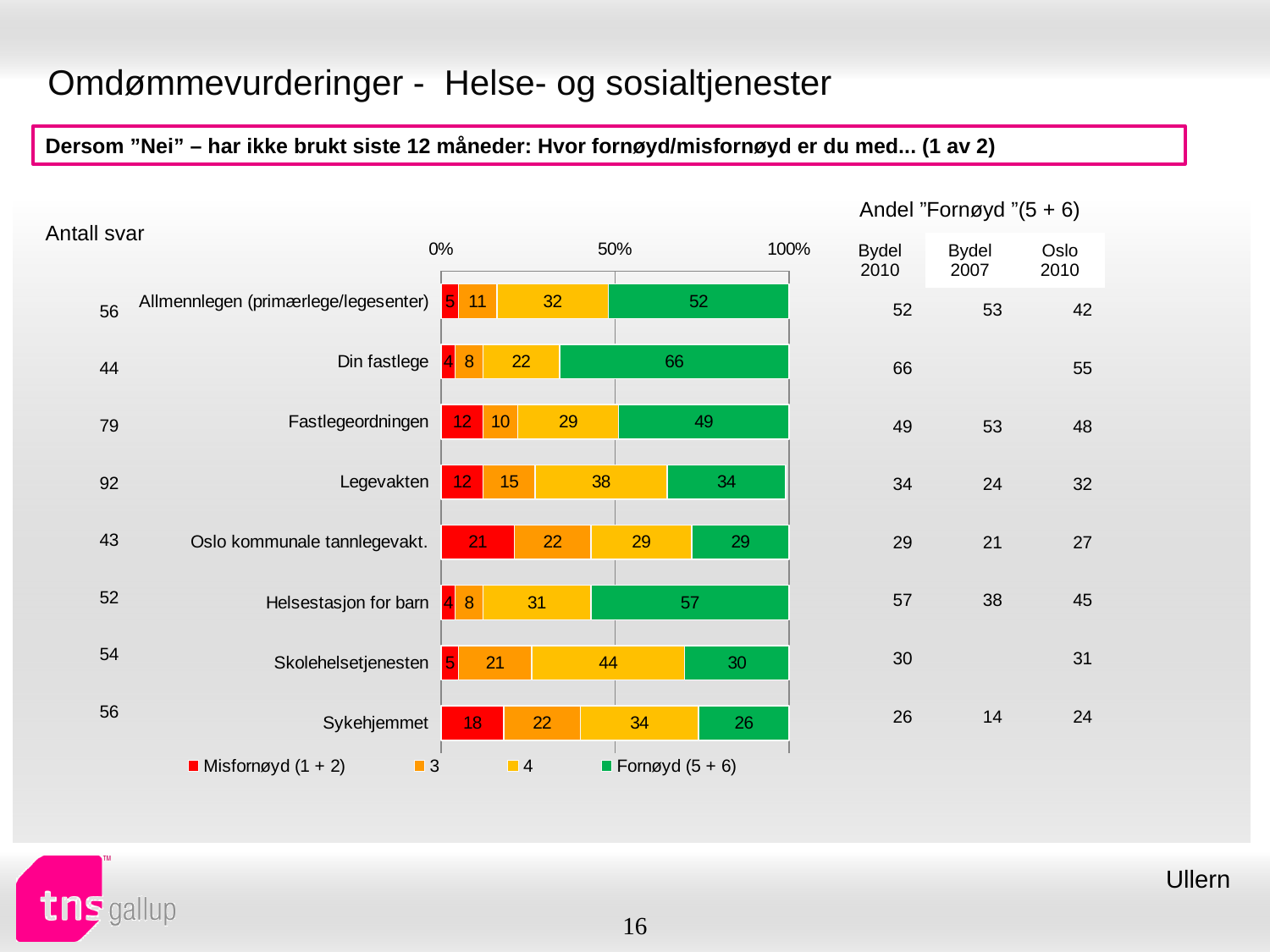
Which category has the highest Misfornøyd (1 + 2) value? Oslo kommunale tannlegevakt. What is the value of the Misfornøyd (1 + 2) series for Sykehjemmet? 18 How many series does the legend list? 4 What kind of chart is shown on the slide? Stacked bar chart What is the difference between the Fornøyd (5 + 6) values for Din fastlege and Sykehjemmet? 40 Which category has the highest Fornøyd (5 + 6) value? Din fastlege What colour represents the Fornøyd (5 + 6) series in the chart? Green Which category has the lowest Fornøyd (5 + 6) value? Sykehjemmet Which has a larger Fornøyd (5 + 6) value, Legevakten or Skolehelsetjenesten? Legevakten How many categories are shown in the bar chart? 8 What is the value of the Fornøyd (5 + 6) series for Din fastlege? 66 What is the value of the series labelled 4 for Skolehelsetjenesten? 44